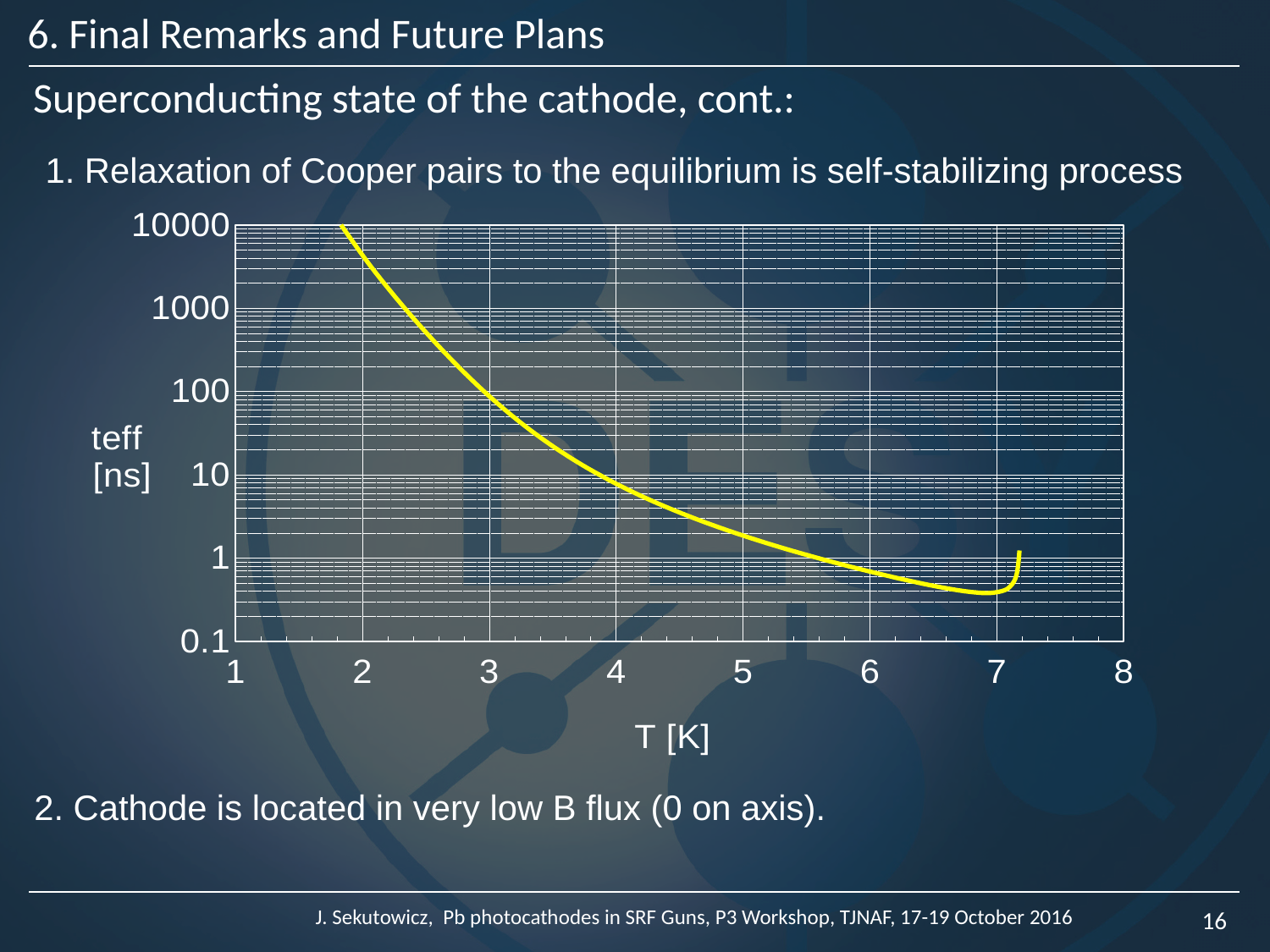
What kind of chart is shown on the slide? line chart Is the value of teff at T = 6 K greater or less than 1 ns? less What is the label of the x axis of the chart? T [K] Is the value of teff at T = 5 K greater or less than 10 ns? less How many curves are plotted on the chart? 1 Which is larger, the value of teff at T = 3 K or at T = 5 K? T = 3 K Is the value of teff at T = 5 K greater or less than 1 ns? greater Near which temperature on the x axis does the curve reach its lowest value? 7 What is the highest tick value shown on the y axis? 10000 Does the plotted value rise or fall as T increases from 2 K to 6 K? fall What is the label of the y axis of the chart? teff [ns]